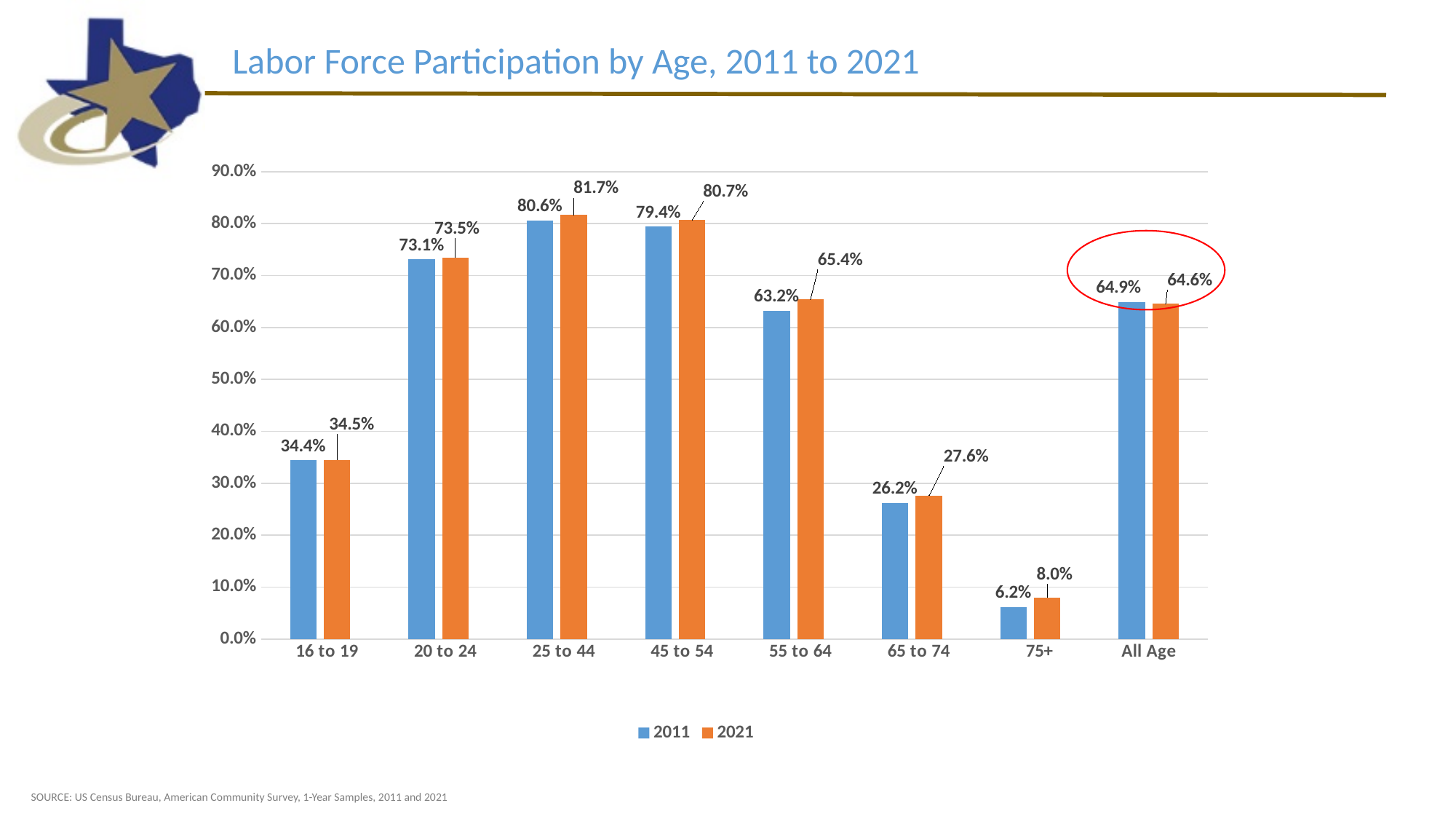
Is the 2021 value for 65 to 74 greater or less than 30.0%? less How many series does the legend list? 2 What is the 2021 labor force participation rate for the 25 to 44 age group? 81.7% What kind of chart is shown on the slide? Bar chart Which age group has the lowest 2011 labor force participation rate? 75+ How many age categories are shown on the x axis? 8 What is the 2011 labor force participation rate for the 75+ age group? 6.2% Which category on the chart is circled in red? All Age Which is larger for All Age: the 2011 value or the 2021 value? 2011 What is the difference between the 2021 and 2011 values for the 55 to 64 age group? 2.2% What is the 2011 value for All Age? 64.9% Which age group has the highest 2021 labor force participation rate? 25 to 44